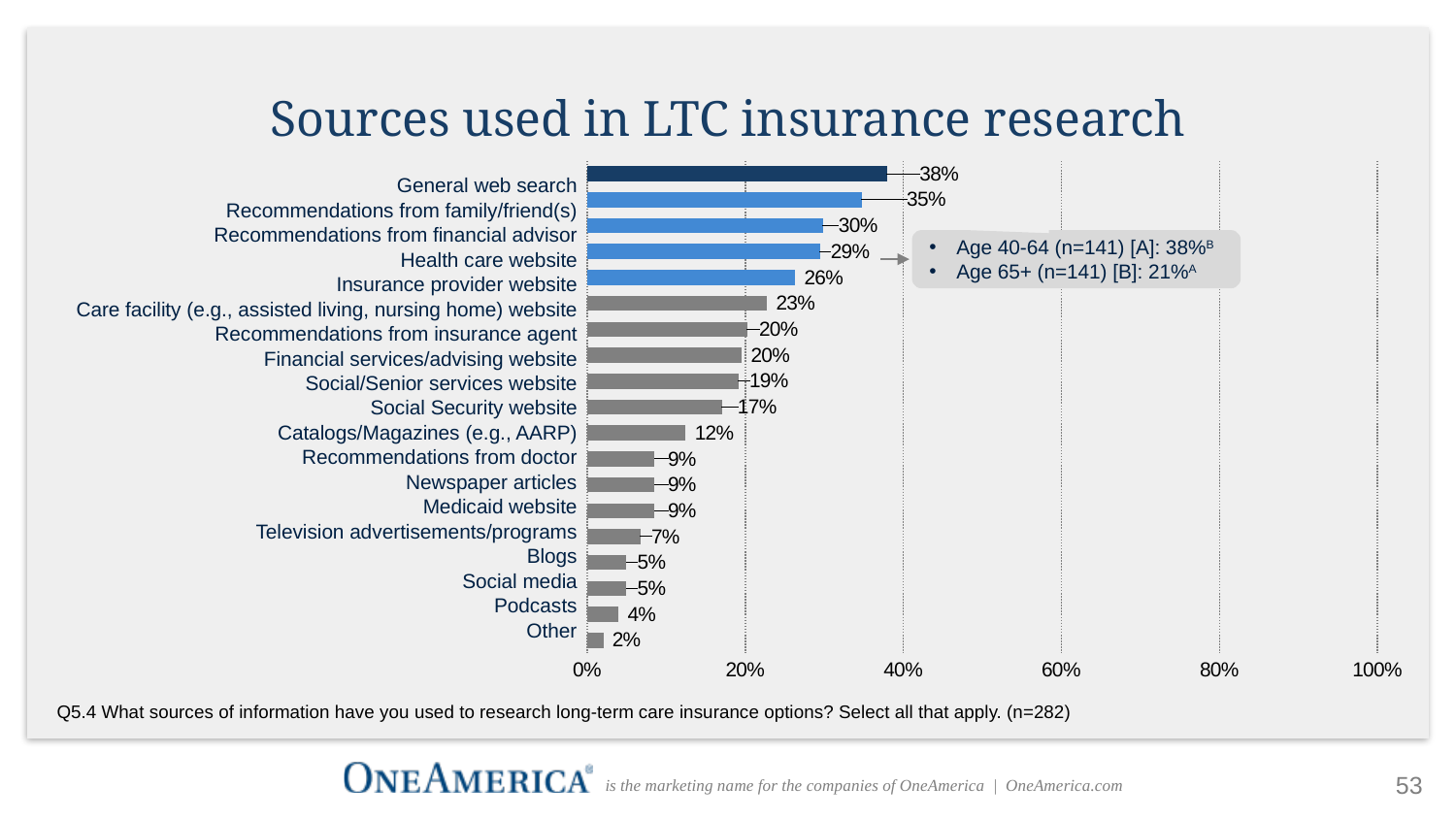
Which source has the highest percentage? General web search How many sources are listed in the chart? 19 Is the value for Health care website greater or less than 20%? greater What is the difference between General web search and Recommendations from family/friend(s)? 3% Which is larger, Insurance provider website or Care facility (e.g., assisted living, nursing home) website? Insurance provider website What is the value for Podcasts? 4% What type of chart is shown on the slide? Bar chart What percentage used the Social Security website? 17% What is the value for Recommendations from financial advisor? 30% What percentage of respondents used a general web search? 38% According to the callout, what is the Health care website value for Age 65+? 21% Which source has the lowest percentage? Other